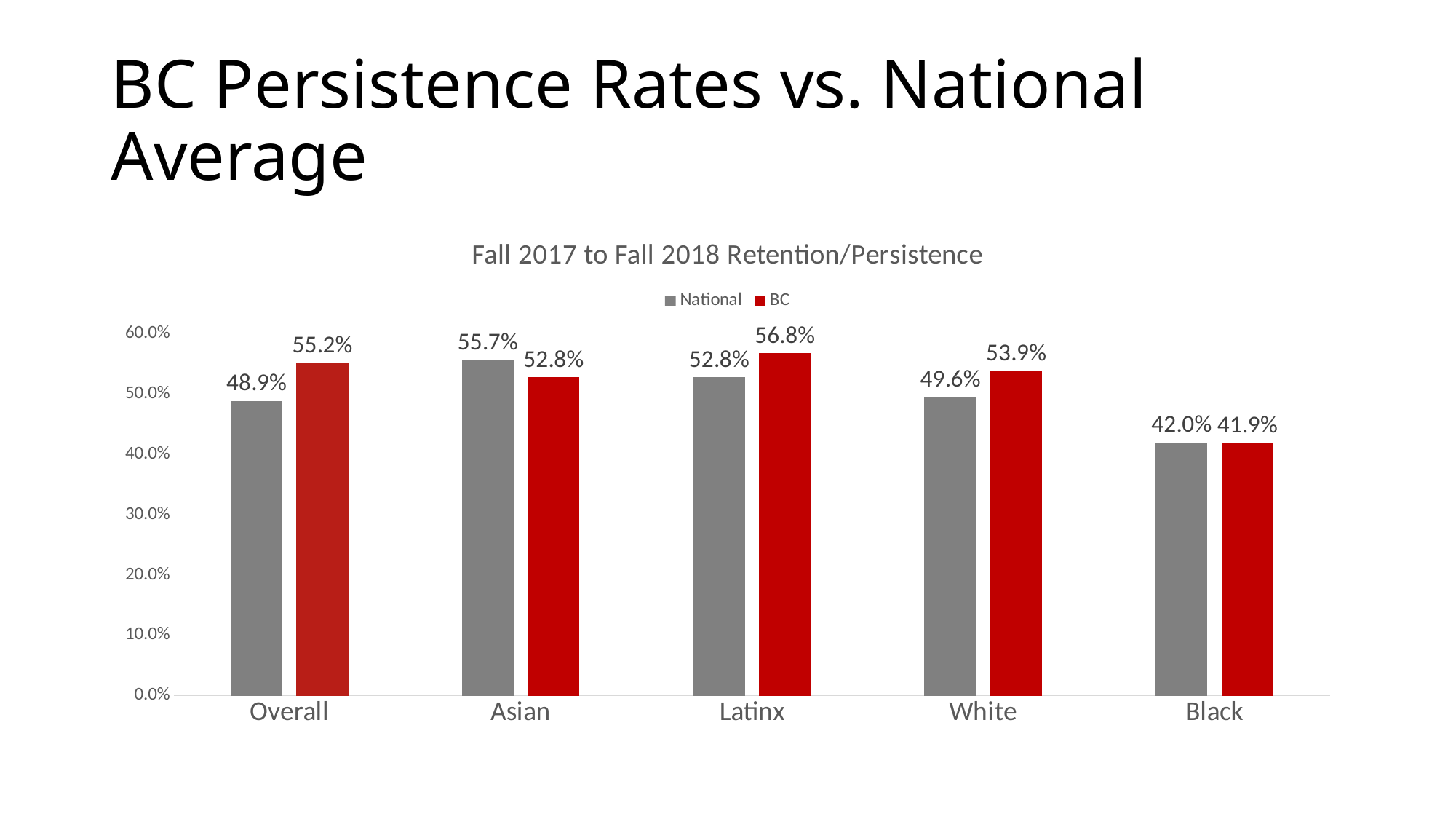
For White students, which is larger, the BC rate or the National rate? BC Which category has the lowest National persistence rate? Black What is the BC persistence rate for Latinx students? 56.8% What type of chart is shown on the slide? Bar chart What is the BC persistence rate for the Overall category? 55.2% Which category has the highest BC persistence rate? Latinx Is the National persistence rate for Black students greater or less than 50.0%? less What is the difference between the National and BC persistence rates for Asian students? 2.9% What is the National persistence rate for Asian students? 55.7% How many categories are shown on the x axis? 5 How many series does the legend list? 2 What is the difference between the BC and National persistence rates for the Overall category? 6.3%